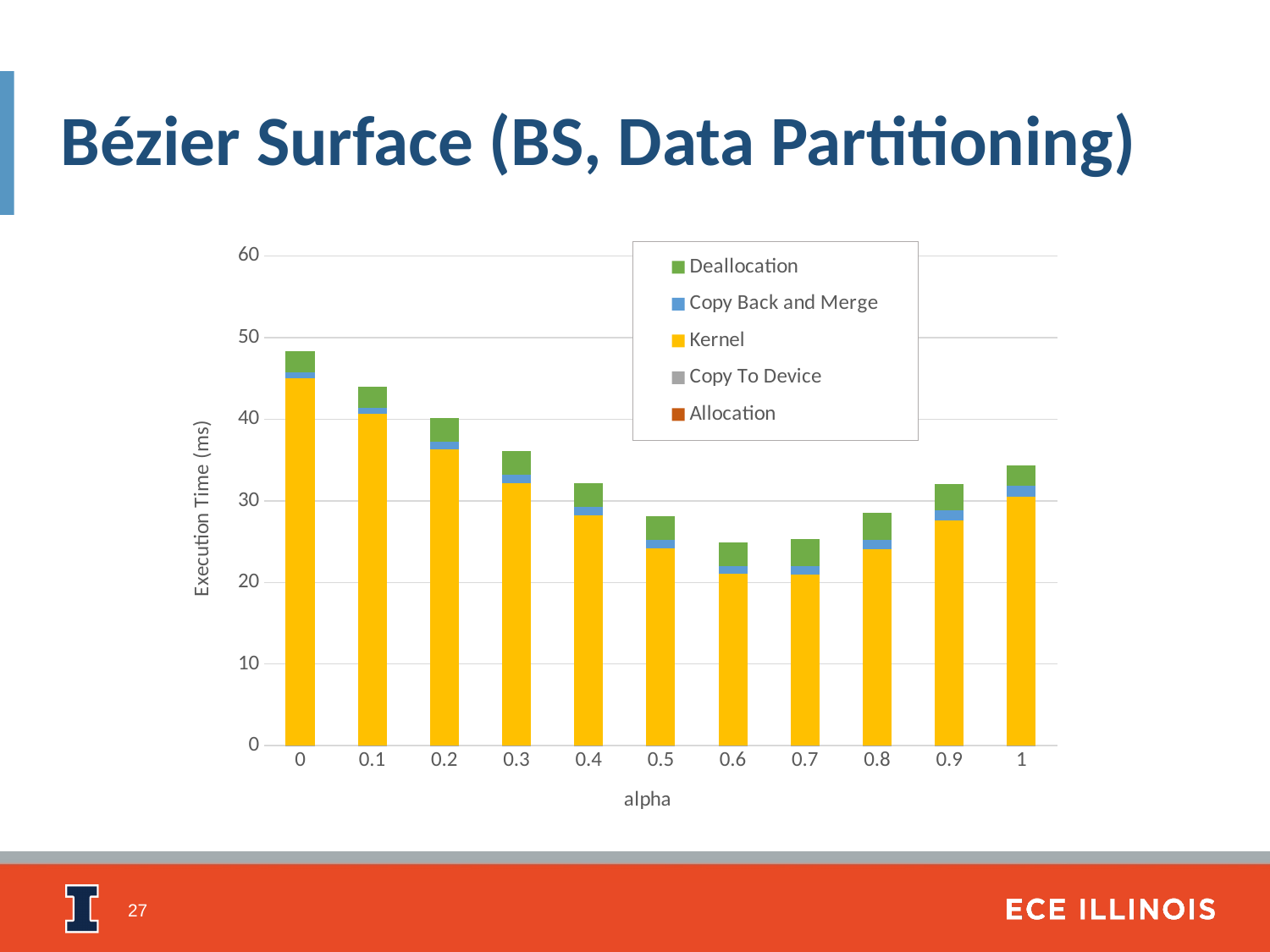
How many alpha values (bars) are plotted along the x axis? 11 Which has the larger total execution time: alpha 0 or alpha 1? alpha 0 Which series makes up the largest portion of each stacked bar? Kernel What kind of chart is shown on the slide? Stacked bar chart Is the total execution time at alpha 0 greater or less than 40 ms? greater Is the total execution time at alpha 0.5 greater or less than 30 ms? less Does the total execution time rise or fall as alpha increases from 0 to 0.5? fall What is the label of the y axis? Execution Time (ms) Is the total execution time at alpha 0.6 greater or less than 20 ms? greater At which alpha value is the total execution time highest? 0 How many series does the legend list? 5